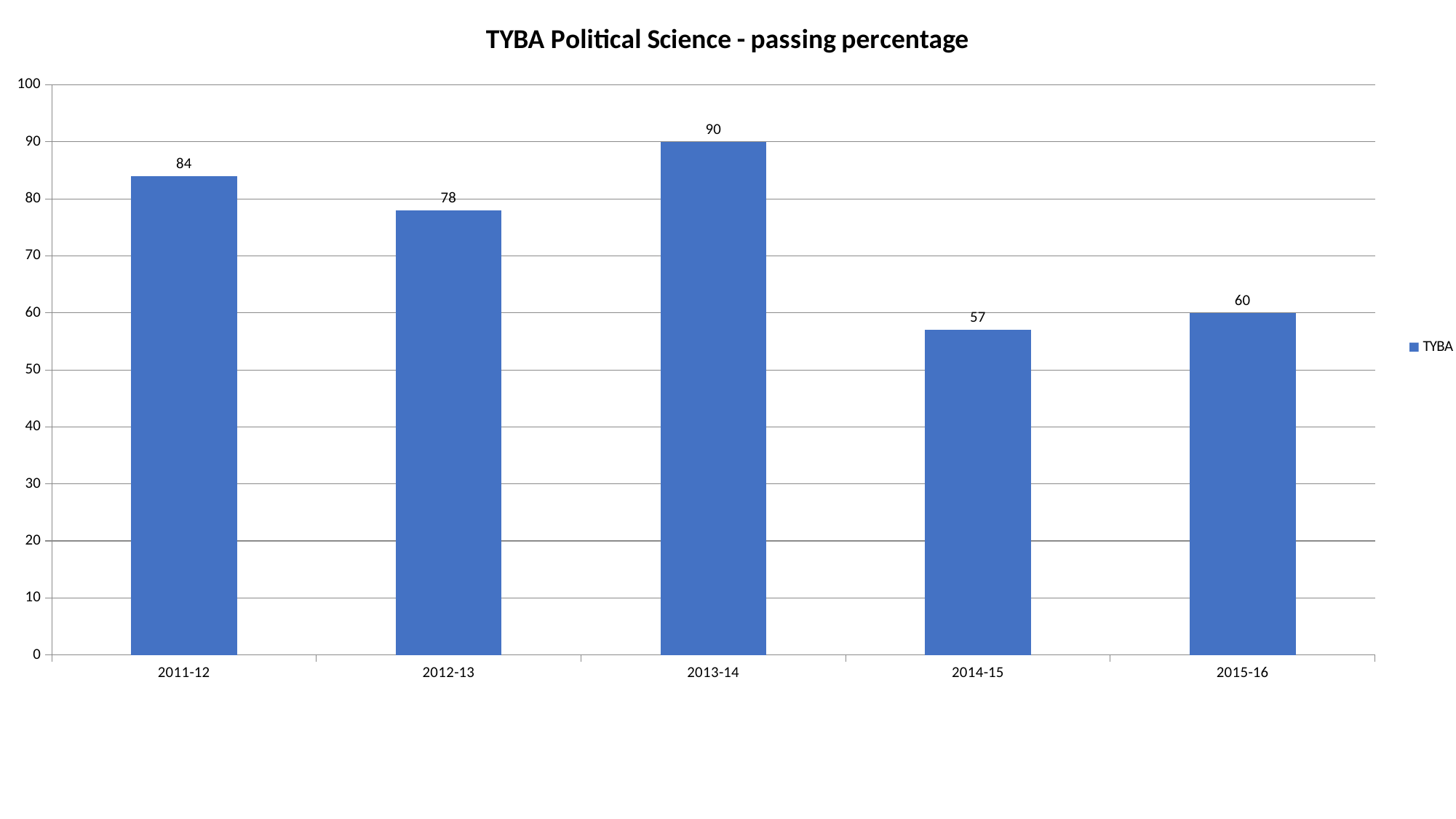
What is the passing percentage for 2014-15? 57 How many years are shown on the x axis? 5 Which year has the highest passing percentage? 2013-14 How many series does the legend list? 1 What kind of chart is shown on the slide? bar chart What is the difference between the passing percentages for 2013-14 and 2012-13? 12 Is the value for 2012-13 greater or less than 70? greater What is the passing percentage for 2011-12? 84 Which is larger, the passing percentage for 2011-12 or for 2015-16? 2011-12 What is the passing percentage for 2015-16? 60 What is the title of the chart? TYBA Political Science - passing percentage Which year has the lowest passing percentage? 2014-15